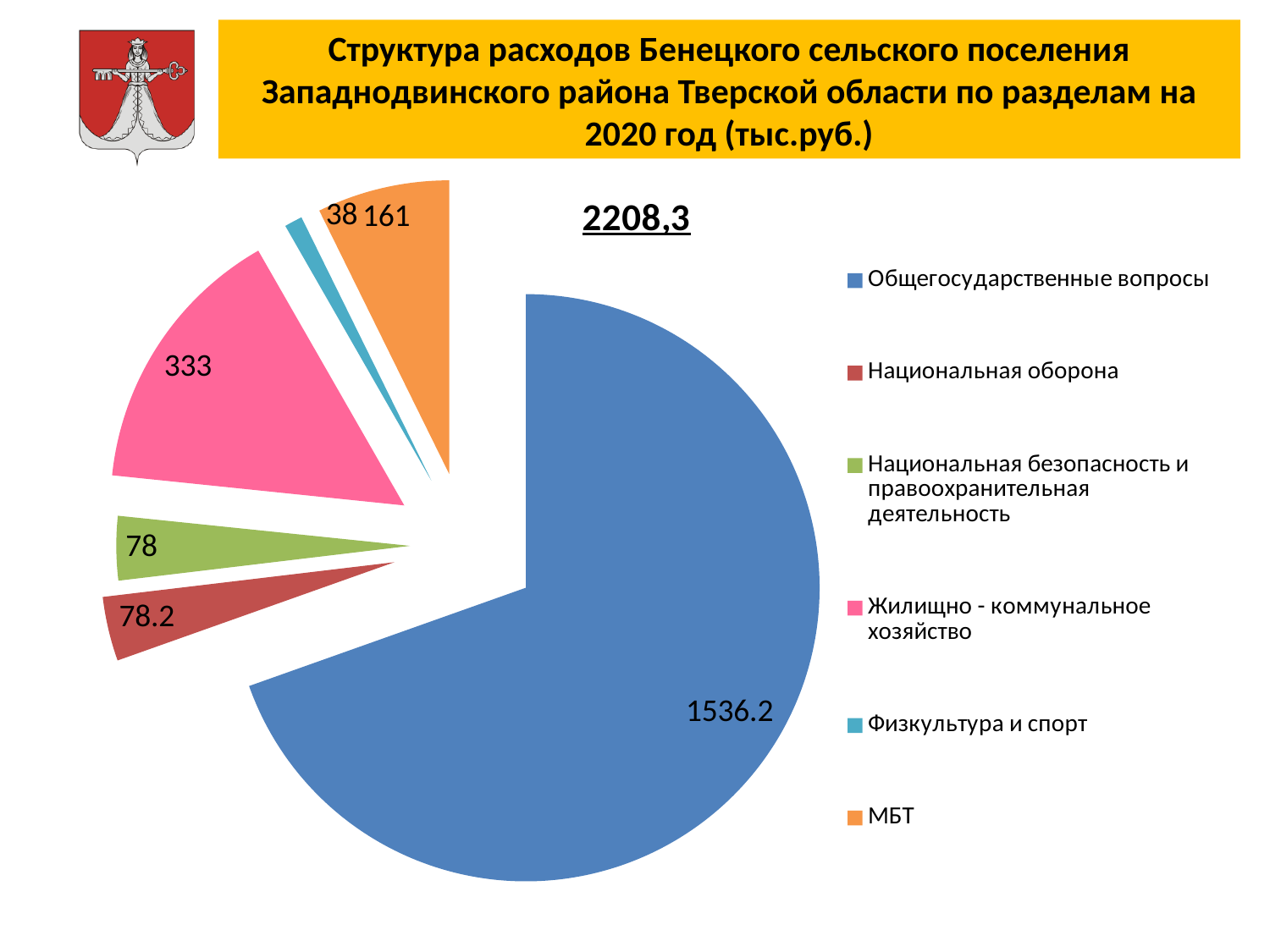
Which category has the smallest slice of the pie? Физкультура и спорт What total value is printed above the pie chart? 2208,3 How many categories are shown in the pie chart? 6 What is the value for Жилищно - коммунальное хозяйство? 333 Which is larger, the value for МБТ or the value for Физкультура и спорт? МБТ What is the difference between the values for Жилищно - коммунальное хозяйство and МБТ? 172 What is the value for Физкультура и спорт? 38 What is the value for Национальная оборона? 78.2 What is the value for МБТ? 161 Which category has the largest slice of the pie? Общегосударственные вопросы What type of chart is shown on the slide? pie chart What is the value for Общегосударственные вопросы? 1536.2